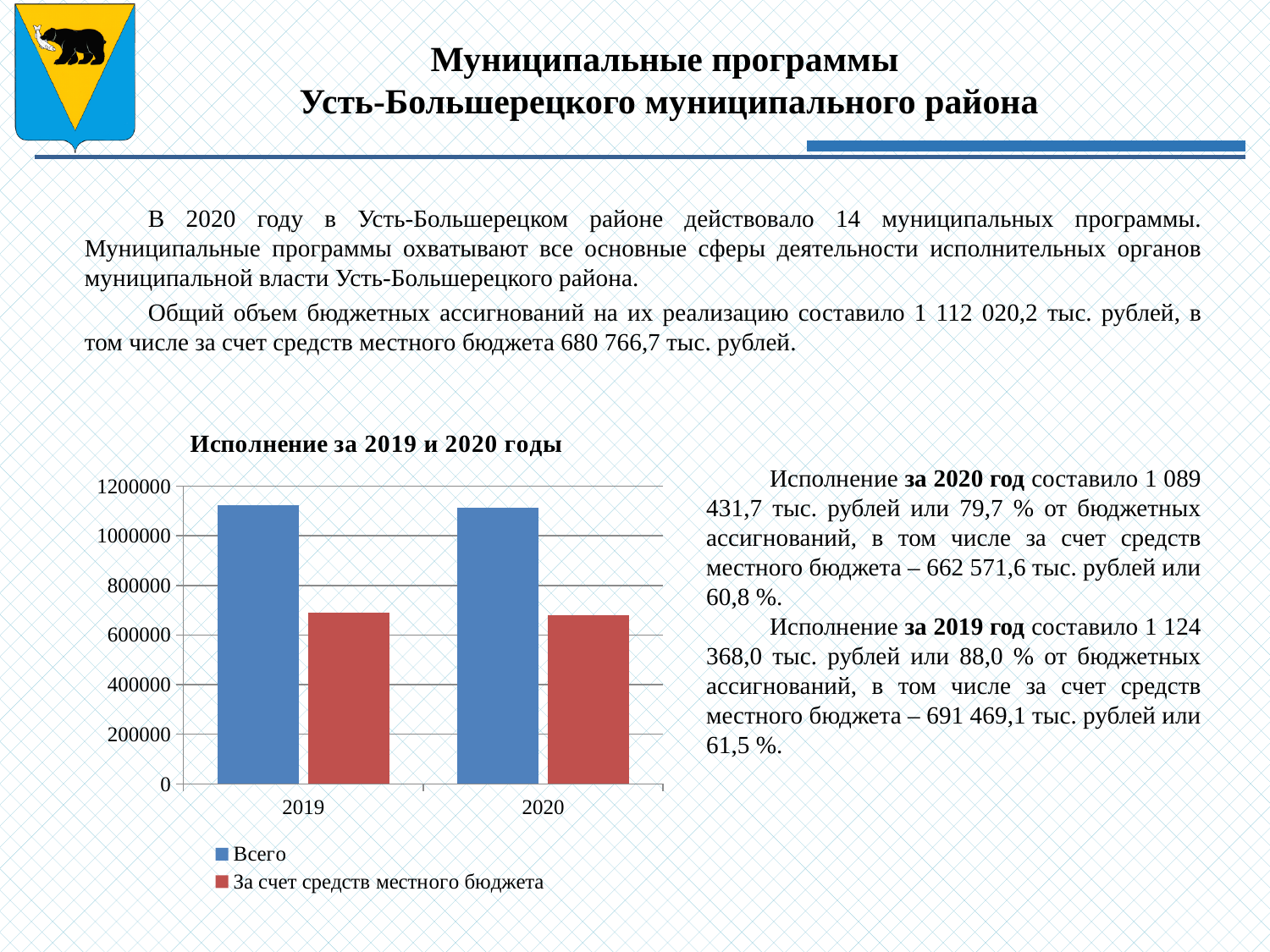
Is the value for За счет средств местного бюджета in 2019 greater or less than 600000? greater How many year categories are shown on the x axis of the chart? 2 What is the title of the chart? Исполнение за 2019 и 2020 годы Is the value for Всего in 2019 greater or less than 1000000? greater Is the value for За счет средств местного бюджета in 2019 greater or less than 800000? less Which series is shown in red in the chart? За счет средств местного бюджета How many series does the chart legend list? 2 In 2020, which is larger: Всего or За счет средств местного бюджета? Всего What kind of chart is shown on the slide? bar chart In 2019, which is larger: Всего or За счет средств местного бюджета? Всего